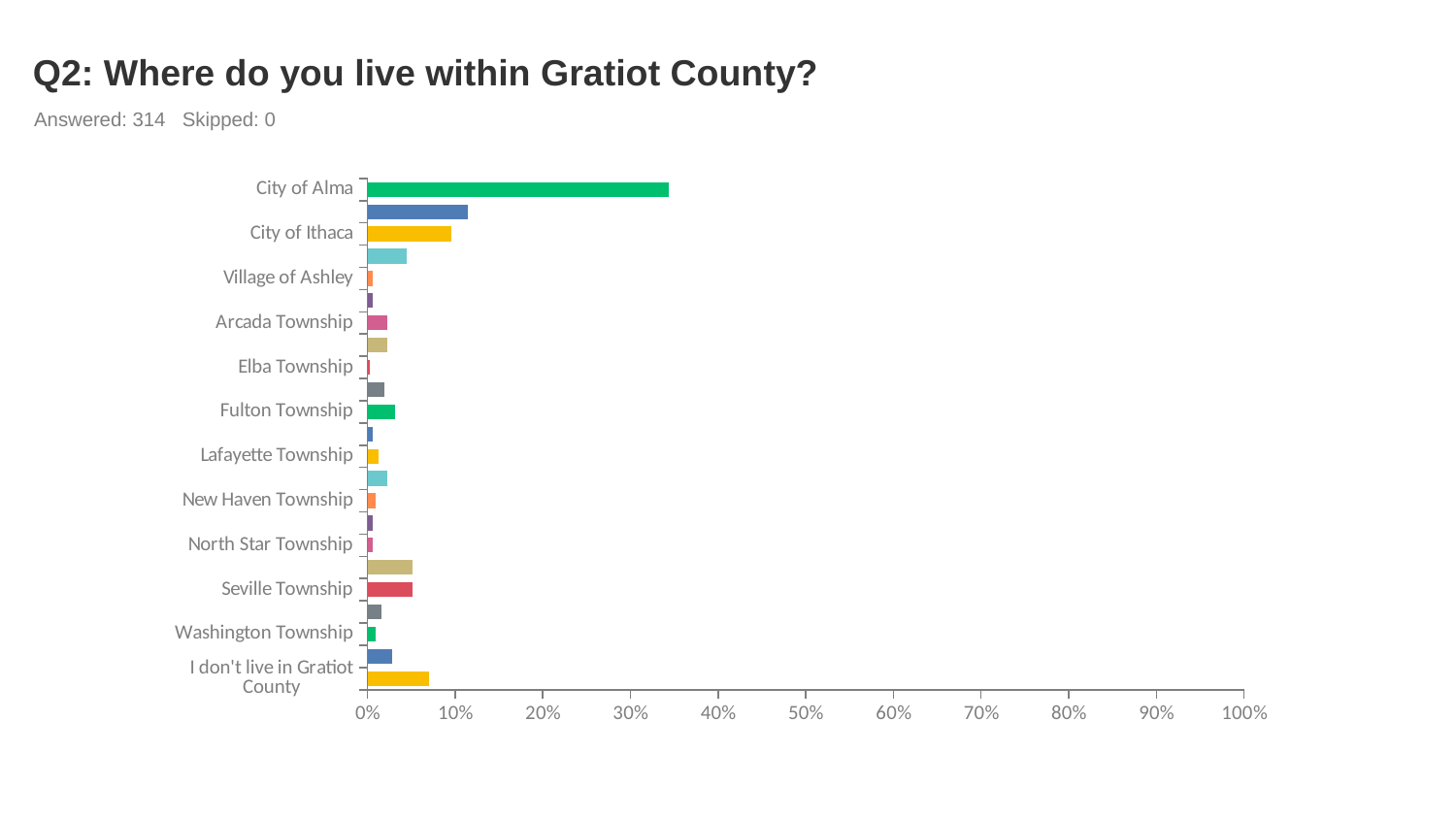
Is the value for City of Alma greater or less than 40%? less Which is larger, the value for Seville Township or the value for Washington Township? Seville Township Is the value for 'I don't live in Gratiot County' greater or less than 10%? less What type of chart is shown on the slide? bar chart Is the value for Seville Township greater or less than 10%? less Which is larger, the value for City of Alma or the value for City of Ithaca? City of Alma Which is larger, the value for Fulton Township or the value for Elba Township? Fulton Township What is the title of the chart? Q2: Where do you live within Gratiot County? Which category has the highest value in the chart? City of Alma How many respondents answered the question according to the slide? 314